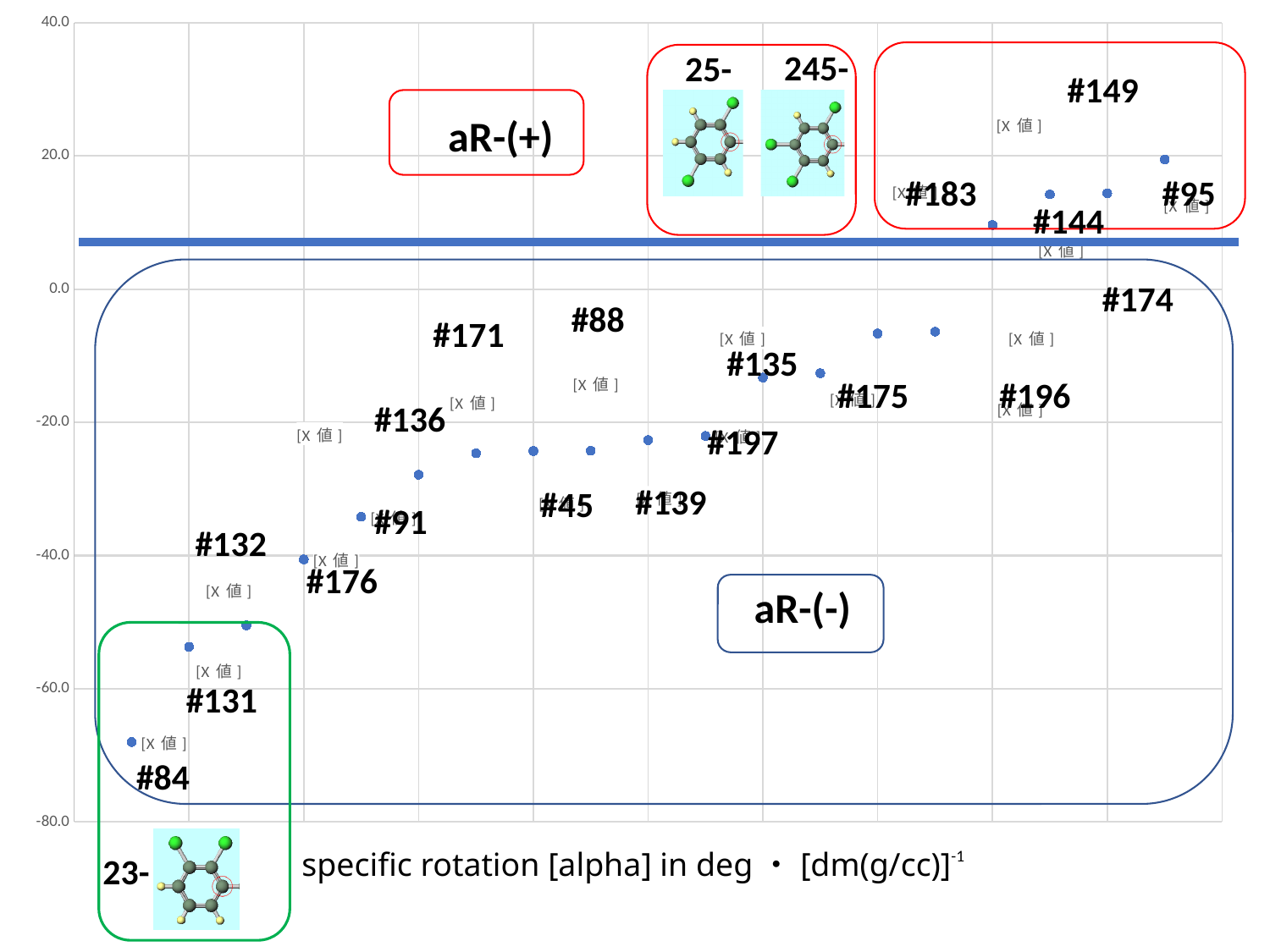
Is the value for #84 greater or less than -60? less Is the value for #135 greater or less than 0? less Which has the larger value, #84 or #95? #95 Is the value for #91 greater or less than -20? less What kind of chart is shown on the slide? scatter chart Which labelled point has the lowest specific rotation value? #84 What is the label of the group enclosed in the red box at the top right of the chart? aR-(+) Which has the larger value, #131 or #135? #135 Do the plotted values rise or fall from left to right along the x axis? rise Which labelled point has the highest specific rotation value? #95